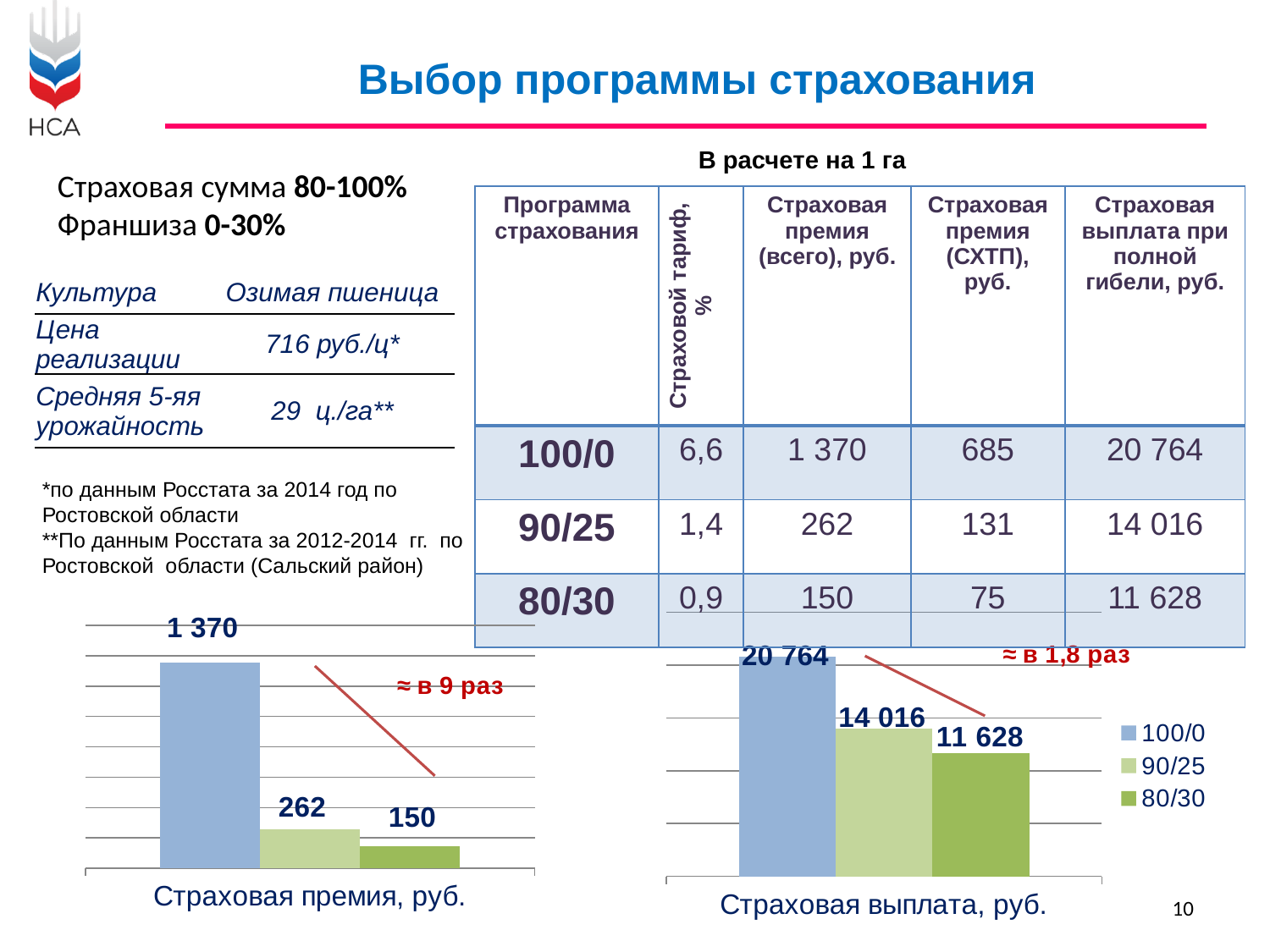
In the chart titled 'Страховая премия, руб.', what is the value for the 80/30 program? 150 In the chart titled 'Страховая выплата, руб.', what is the value for the 80/30 program? 11 628 What type of chart is the one titled 'Страховая премия, руб.'? Bar chart How many bars are shown in the chart titled 'Страховая выплата, руб.'? 3 In the chart titled 'Страховая премия, руб.', what is the difference between the values for 90/25 and 80/30? 112 In the chart titled 'Страховая выплата, руб.', what is the value for the 90/25 program? 14 016 In the chart titled 'Страховая выплата, руб.', what is the difference between the values for 100/0 and 90/25? 6 748 In the chart titled 'Страховая премия, руб.', which is larger: the value for 100/0 or the value for 90/25? 100/0 In the chart titled 'Страховая выплата, руб.', which program has the highest value? 100/0 In the chart titled 'Страховая премия, руб.', which program has the lowest value? 80/30 In the chart titled 'Страховая премия, руб.', what is the value for the 100/0 program? 1 370 How many entries does the legend next to the chart titled 'Страховая выплата, руб.' list? 3